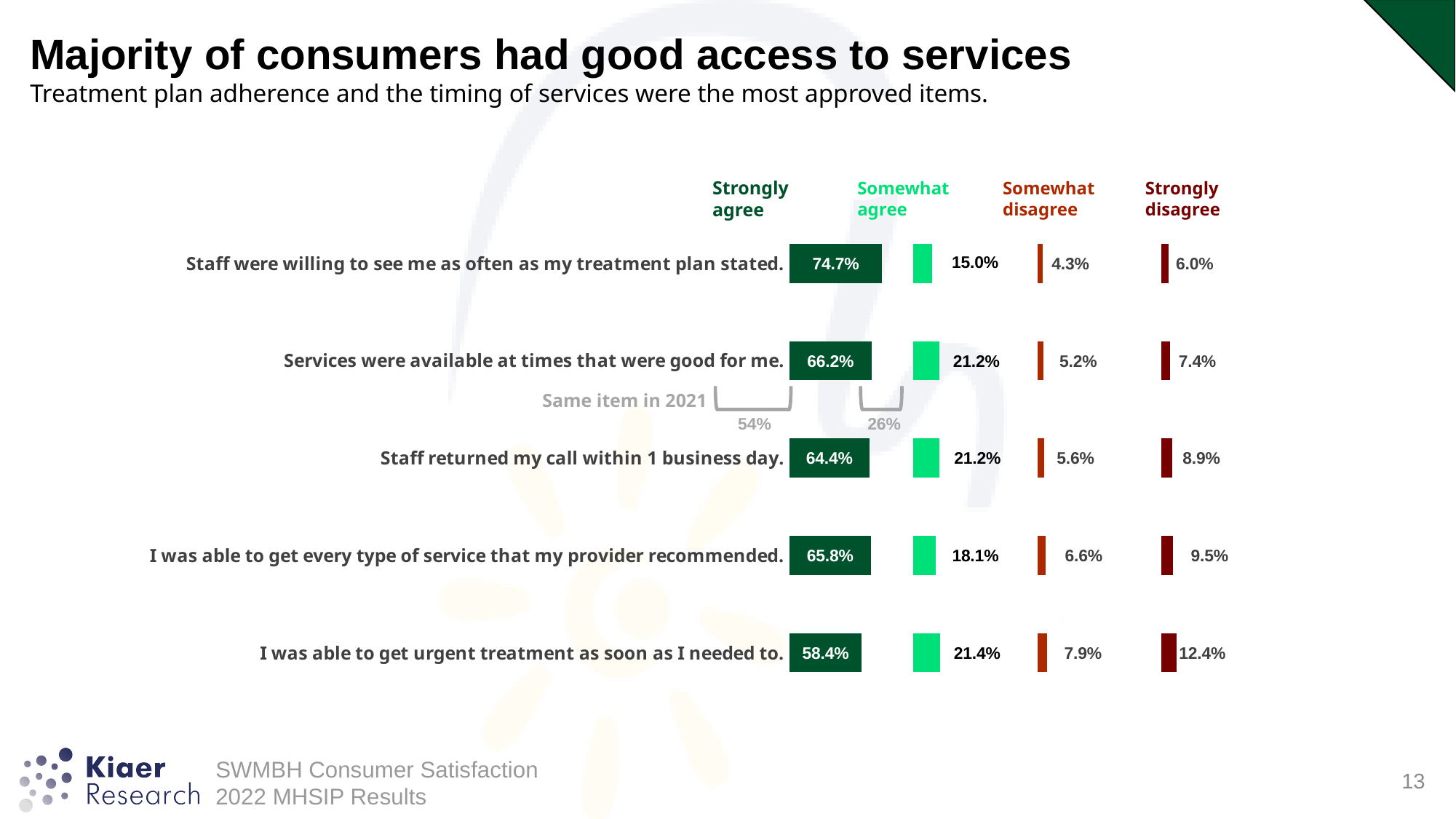
What is the 'Strongly disagree' value for 'I was able to get urgent treatment as soon as I needed to.'? 12.4% What is the 'Somewhat disagree' value for 'Staff returned my call within 1 business day.'? 5.6% What is the difference between the 'Strongly agree' values for 'Services were available at times that were good for me.' and 'Staff returned my call within 1 business day.'? 1.8% Which item has the lowest 'Strongly agree' percentage? I was able to get urgent treatment as soon as I needed to. How many response categories (series) does the chart show? 4 What was the 'Strongly agree' value for 'Services were available at times that were good for me.' in 2021? 54% How many survey items are shown in the chart? 5 What is the total of the 'Strongly agree' and 'Somewhat agree' values for 'I was able to get urgent treatment as soon as I needed to.'? 79.8% What percentage of consumers strongly agreed that staff were willing to see them as often as their treatment plan stated? 74.7% Which is larger: the 'Strongly disagree' value for 'I was able to get every type of service that my provider recommended.' or for 'Services were available at times that were good for me.'? I was able to get every type of service that my provider recommended. What kind of chart is shown on the slide? Bar chart Which item has the highest 'Strongly agree' percentage? Staff were willing to see me as often as my treatment plan stated.